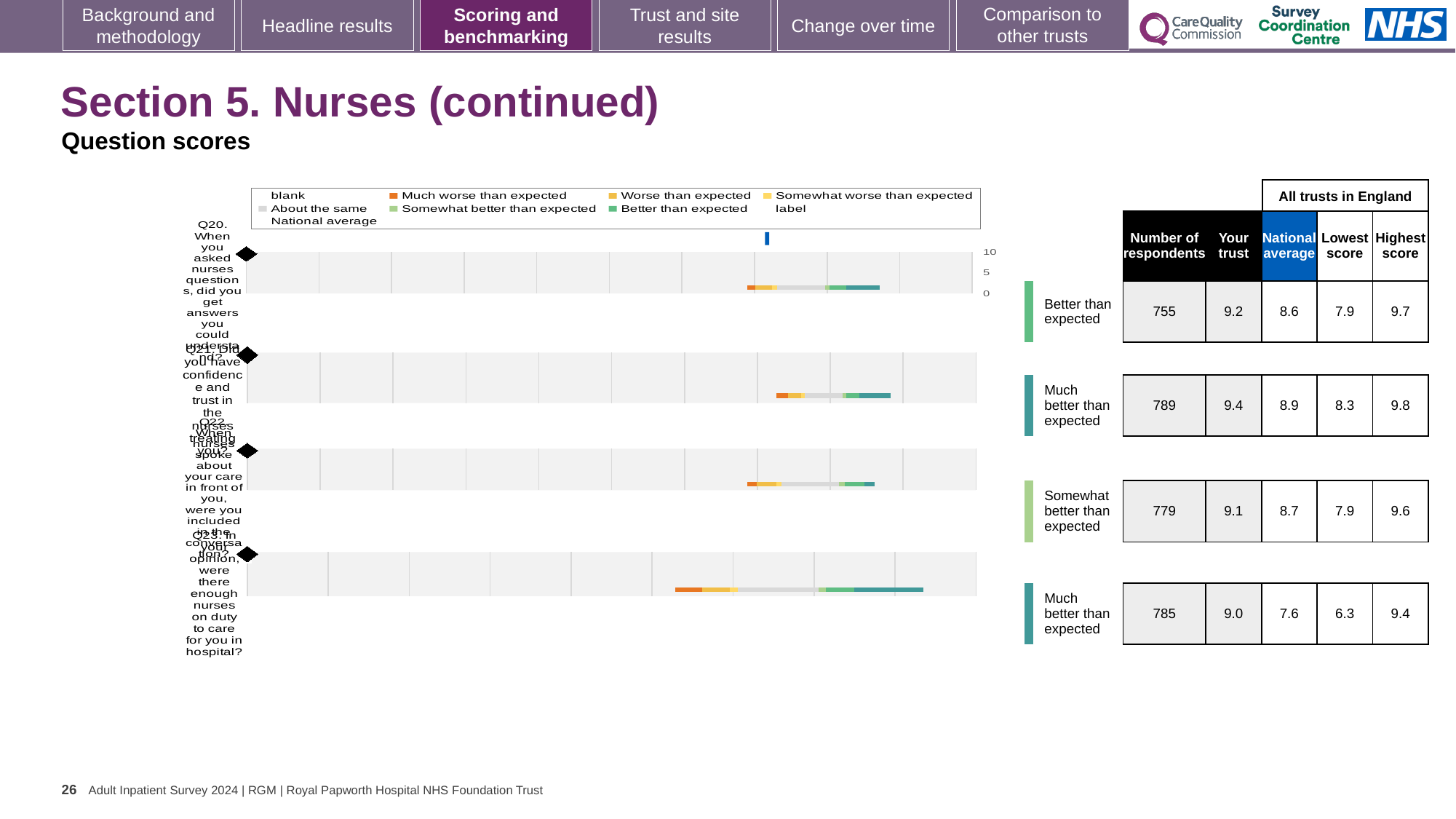
What benchmark rating is shown beside the Q20 chart? Better than expected What kind of chart is used to show the question scores for Q20 to Q23? bar chart How many question charts (Q20 to Q23) are shown on the slide? 4 What colour does the legend use for 'Much worse than expected'? orange For the Q23 row, what is the difference between the 'Your trust' score (9.0) and the national average (7.6)? 1.4 In the table beside the Q21 chart, what is the 'Your trust' score? 9.4 For the Q21 row, which is larger: the 'Your trust' score or the national average? Your trust How many entries does the legend above the question charts list? 9 In the table beside the Q22 chart, what is the highest score among all trusts in England? 9.6 In the table beside the Q23 chart, what is the lowest score among all trusts in England? 6.3 In the table beside the Q20 chart, what is the number of respondents? 755 What is the highest value shown on the axis of the Q20 chart? 10